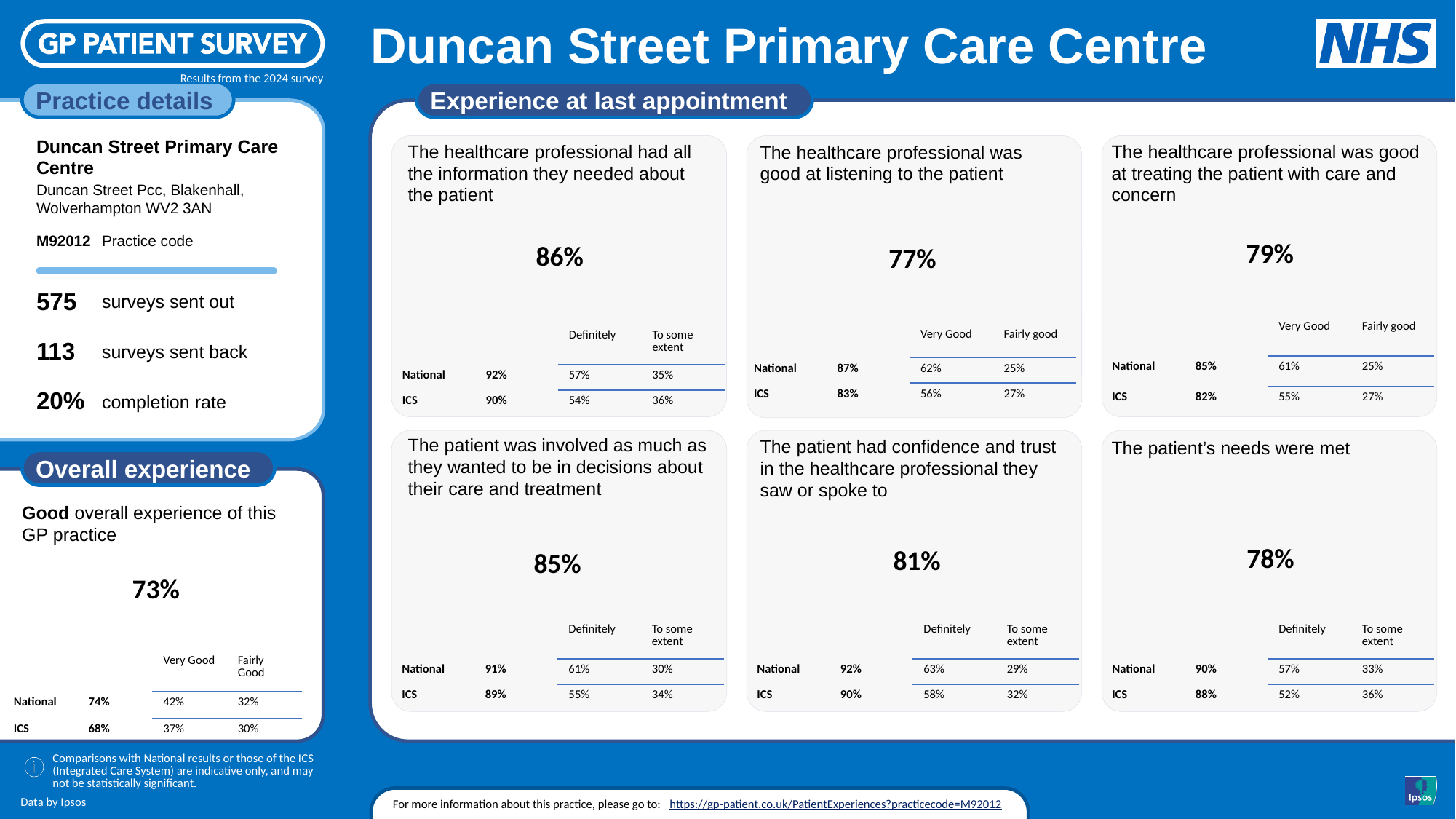
In the 'Overall experience' panel, what percentage of patients reported a good overall experience of this GP practice? 73% How many statement panels are shown under the 'Experience at last appointment' heading? 6 In the 'Overall experience' panel, what is the National figure for good overall experience? 74% Among the six 'Experience at last appointment' panels, which statement has the highest practice percentage? The healthcare professional had all the information they needed about the patient Among the six 'Experience at last appointment' panels, which statement has the lowest practice percentage? The healthcare professional was good at listening to the patient In the panel 'The healthcare professional was good at listening to the patient', what is the National 'Very Good' percentage? 62% In the panel 'The patient had confidence and trust in the healthcare professional they saw or spoke to', what is the difference between the National figure (92%) and the practice figure (81%)? 11 percentage points In the panel 'The healthcare professional was good at treating the patient with care and concern', what is the ICS overall figure? 82% In the 'Overall experience' panel, what is the ICS 'Very Good' percentage? 37% In the panel 'The patient was involved as much as they wanted to be in decisions about their care and treatment', what is the ICS 'To some extent' percentage? 34% In the panel 'The healthcare professional had all the information they needed about the patient', what is the practice's headline percentage? 86% In the panel 'The patient's needs were met', is the practice figure (78%) higher or lower than the ICS figure (88%)? lower